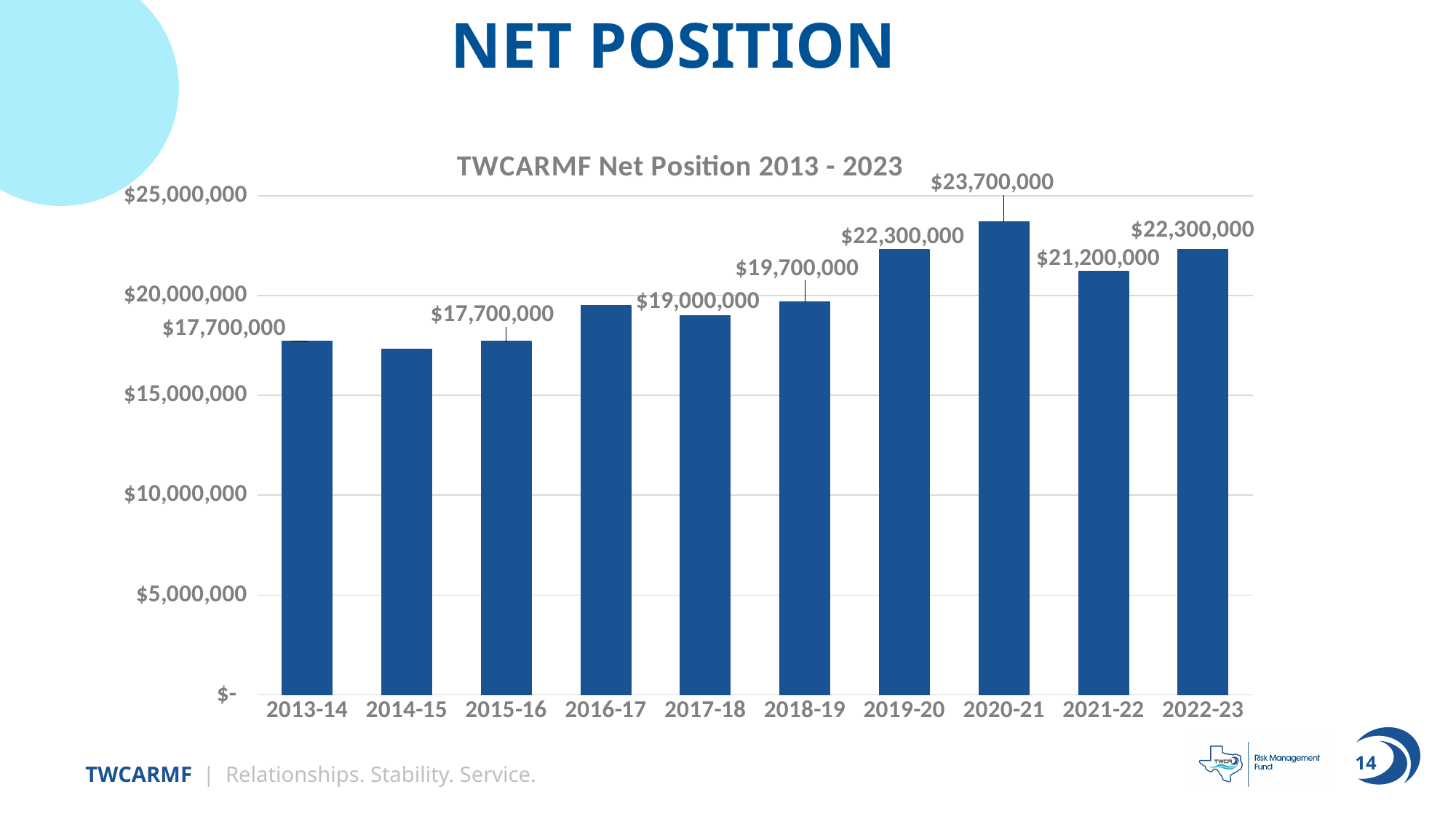
What is the difference between the net position in 2020-21 and in 2021-22? $2,500,000 Is the value for 2016-17 greater or less than $20,000,000? less What is the title of the chart? TWCARMF Net Position 2013 - 2023 Which fiscal year has the lowest net position? 2014-15 Which fiscal year has the highest net position? 2020-21 What is the net position for 2022-23? $22,300,000 How many fiscal years are shown on the x axis? 10 What is the net position for 2020-21? $23,700,000 What is the net position for 2021-22? $21,200,000 What kind of chart is shown on the slide? Bar chart What is the net position for 2018-19? $19,700,000 Which is larger, the net position in 2019-20 or in 2021-22? 2019-20